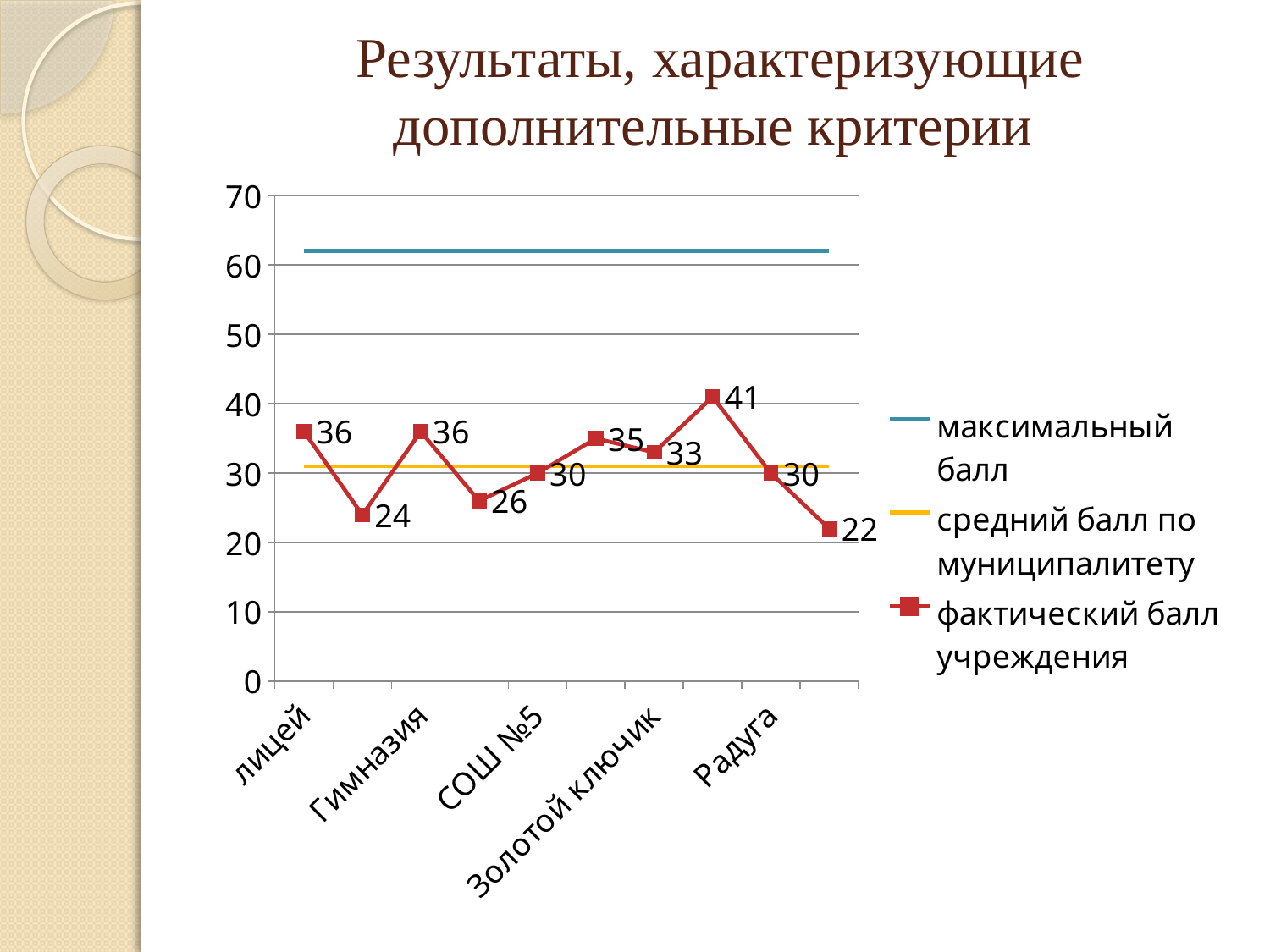
What is the фактический балл учреждения value for Золотой ключик? 33 What is the фактический балл учреждения value for Радуга? 30 What kind of chart is shown on the slide? line chart What is the фактический балл учреждения value for Гимназия? 36 What is the highest value labelled on the фактический балл учреждения line? 41 What is the фактический балл учреждения value for лицей? 36 What is the difference between the фактический балл учреждения values for Золотой ключик and Радуга? 3 How many series does the legend list? 3 What is the lowest value labelled on the фактический балл учреждения line? 22 Is the максимальный балл line greater or less than 60? greater What is the фактический балл учреждения value for СОШ №5? 30 Which has the higher фактический балл учреждения value, лицей or СОШ №5? лицей